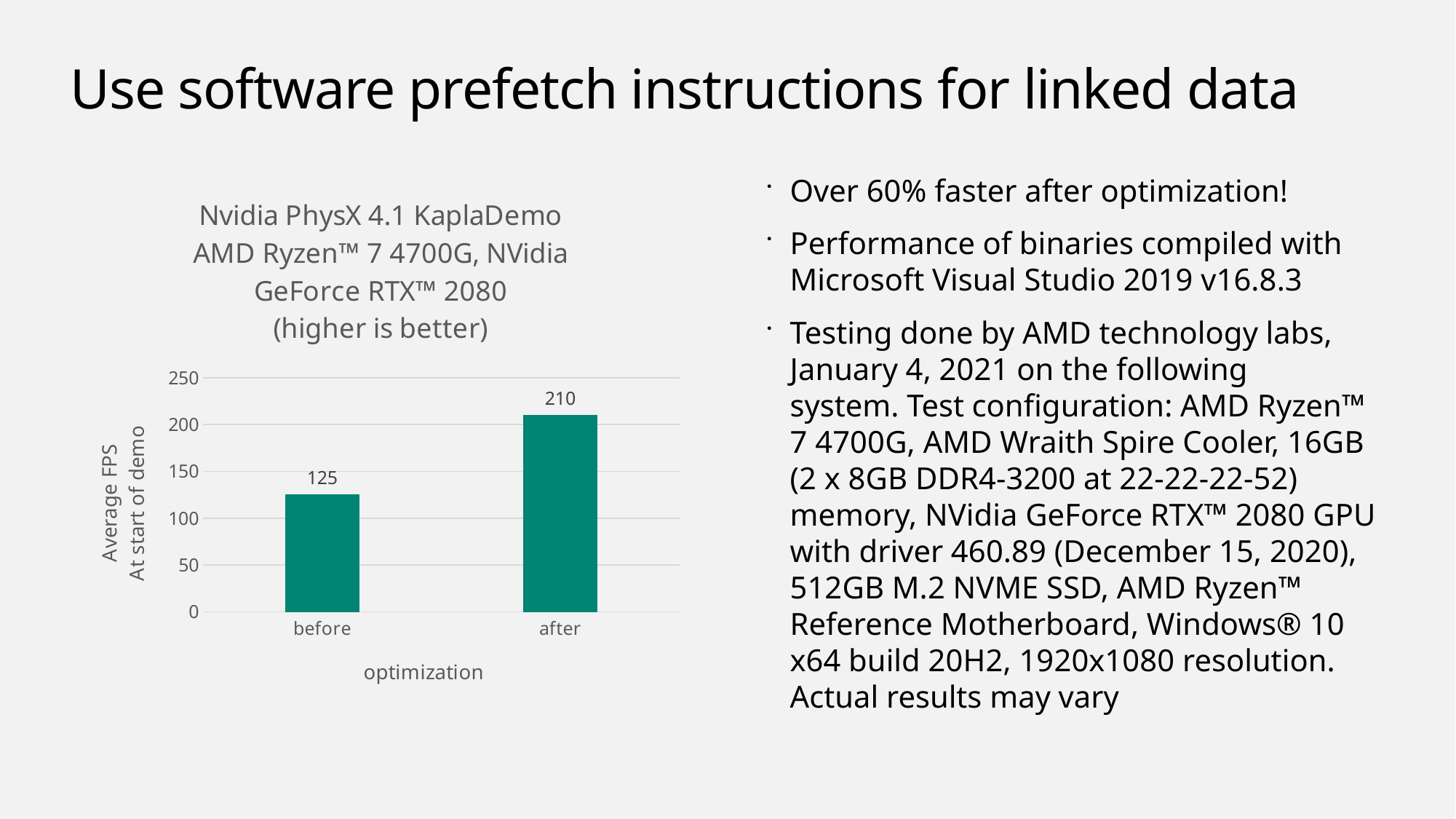
Which is larger, the value for "before" or the value for "after"? after What is the average FPS for the "after" bar? 210 Is the value for "after" greater or less than 200? greater What is the average FPS for the "before" bar? 125 Do the values rise or fall from "before" to "after"? rise What kind of chart is shown on the slide? bar chart How many categories are shown on the x axis of the chart? 2 What is the label of the x axis of the chart? optimization Which category has the lowest average FPS? before Which category has the highest average FPS? after Is the value for "before" greater or less than 150? less What is the difference in average FPS between "after" and "before"? 85